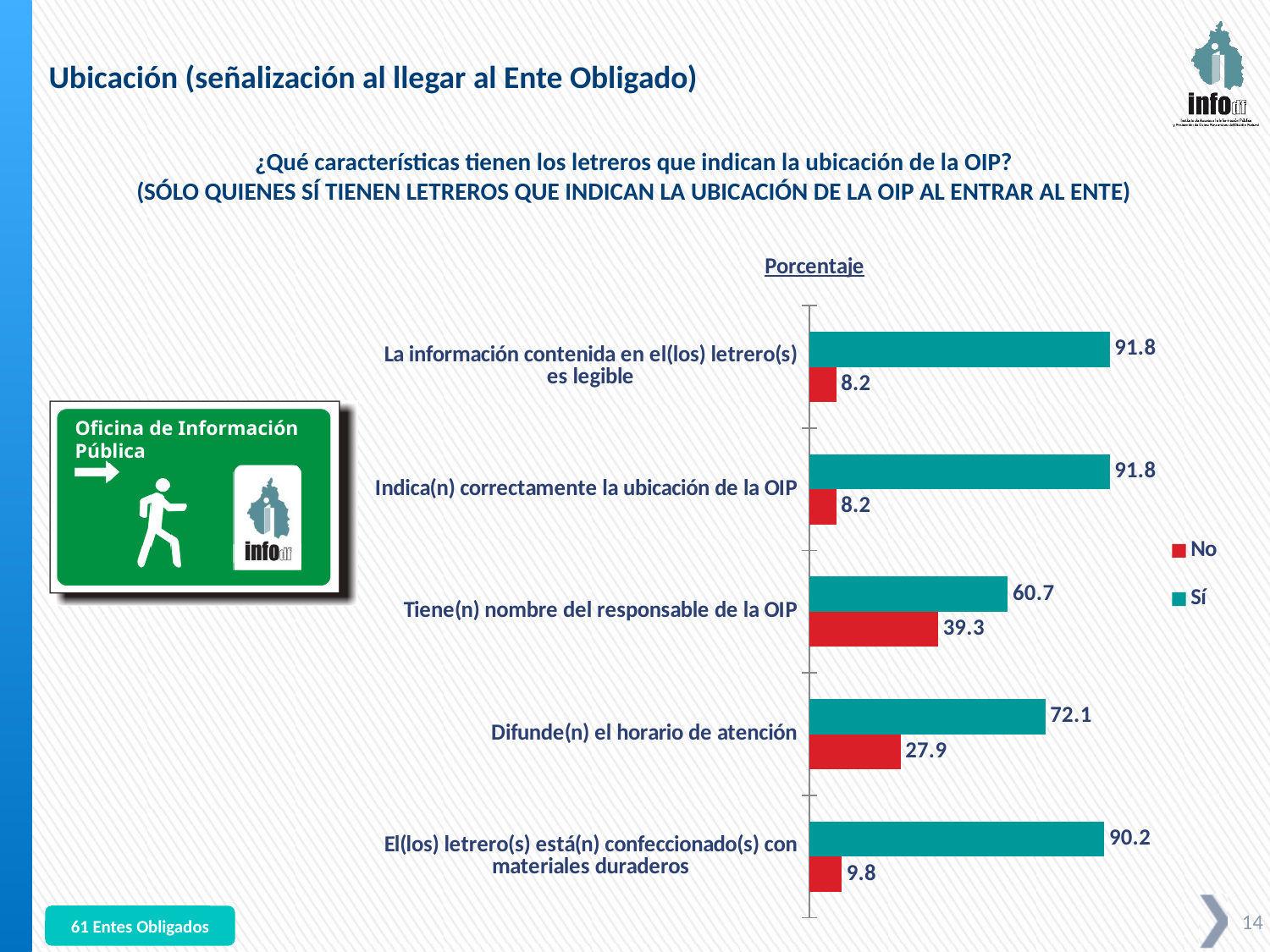
What is the "No" value for "Tiene(n) nombre del responsable de la OIP"? 39.3 What kind of chart is shown on the slide? Bar chart Which is larger: the "No" value for "Difunde(n) el horario de atención" or the "No" value for "El(los) letrero(s) está(n) confeccionado(s) con materiales duraderos"? Difunde(n) el horario de atención Which category has the lowest "Sí" value? Tiene(n) nombre del responsable de la OIP What is the "No" value for "Indica(n) correctamente la ubicación de la OIP"? 8.2 What is the difference between the "Sí" and "No" values for "Difunde(n) el horario de atención"? 44.2 What is the "Sí" value for "Difunde(n) el horario de atención"? 72.1 What is the "Sí" value for "El(los) letrero(s) está(n) confeccionado(s) con materiales duraderos"? 90.2 How many series does the legend list? 2 How many categories are shown in the chart? 5 What is the difference between the "Sí" values for "El(los) letrero(s) está(n) confeccionado(s) con materiales duraderos" and "Tiene(n) nombre del responsable de la OIP"? 29.5 Which category has the highest "No" value? Tiene(n) nombre del responsable de la OIP